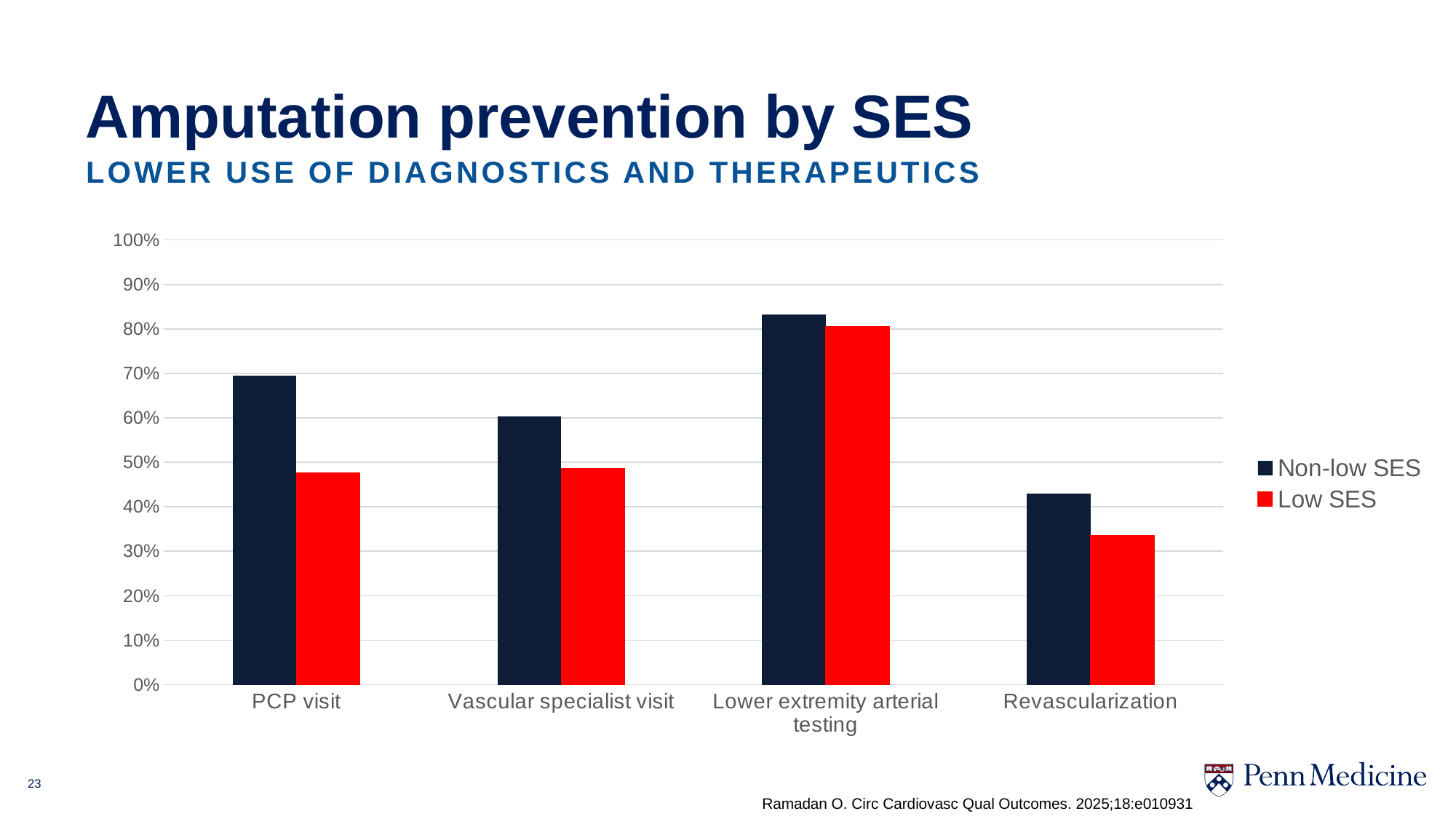
Which category has the lowest Low SES value? Revascularization Is the Low SES value for Lower extremity arterial testing greater or less than 70%? greater Is the Low SES value for Revascularization greater or less than 40%? less What colour are the Low SES bars? red Which category has the highest Non-low SES value? Lower extremity arterial testing Which is larger for Non-low SES: PCP visit or Vascular specialist visit? PCP visit How many categories are shown on the x axis? 4 What kind of chart is shown on the slide? bar chart For PCP visit, which series has the larger value, Non-low SES or Low SES? Non-low SES How many series does the legend list? 2 Is the Non-low SES value for PCP visit greater or less than 60%? greater